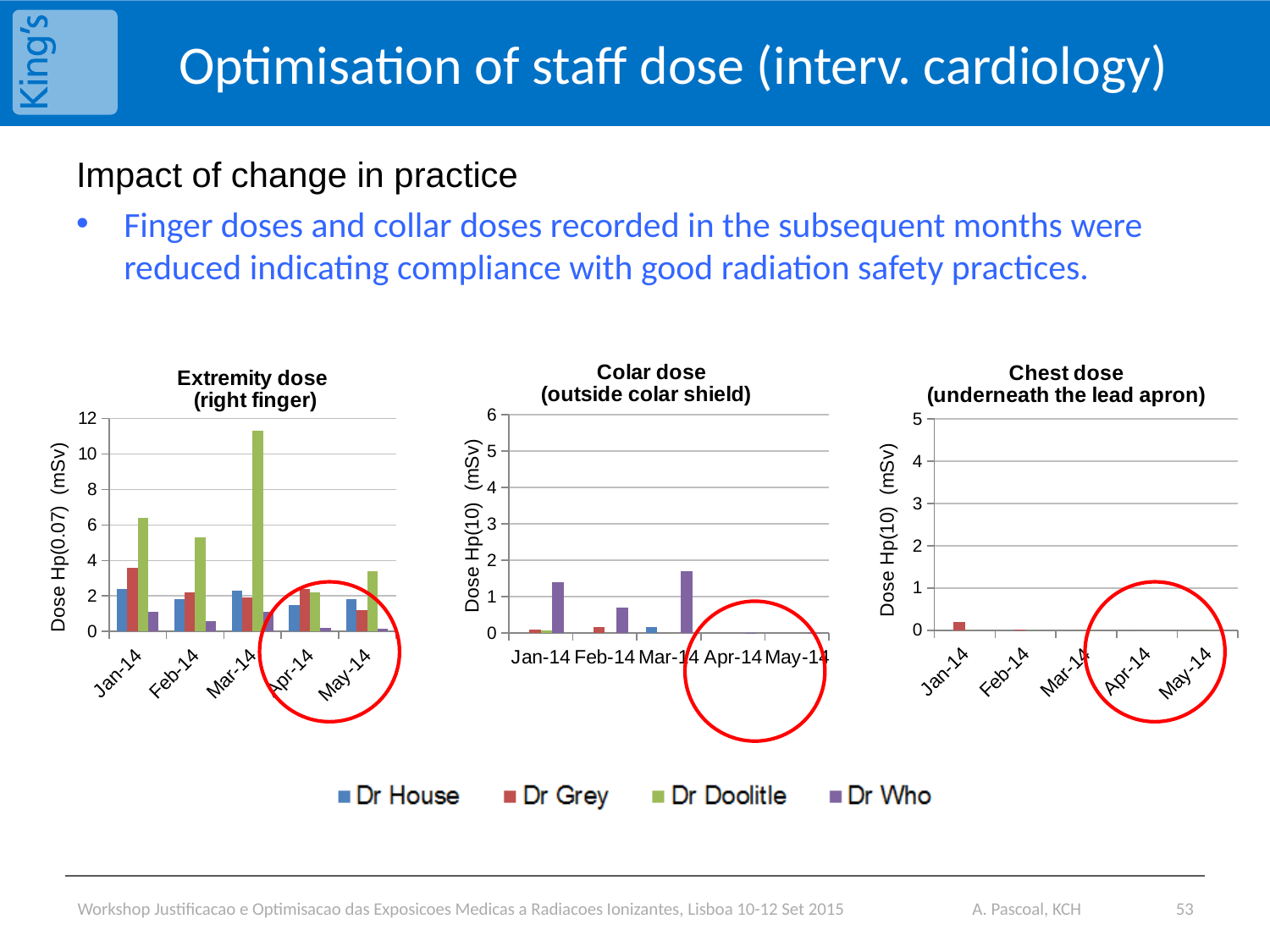
In the Chest dose (underneath the lead apron) chart, which doctor has the highest dose in Jan-14? Dr Grey In the Extremity dose (right finger) chart, which is larger in Jan-14: Dr Grey or Dr House? Dr Grey In the Extremity dose (right finger) chart, does Dr Who's dose rise or fall from Jan-14 to May-14? fall What is the y-axis label of the Colar dose (outside colar shield) chart? Dose Hp(10) (mSv) In the Extremity dose (right finger) chart, which doctor has the highest dose in Mar-14? Dr Doolitle What kind of chart is the Extremity dose (right finger) chart? bar chart How many series does the shared legend below the charts list? 4 In the Extremity dose (right finger) chart, is Dr Doolitle's Feb-14 value greater or less than 4? greater In the Extremity dose (right finger) chart, is Dr Doolitle's Mar-14 value greater or less than 10? greater How many months are shown on the x axis of the Extremity dose (right finger) chart? 5